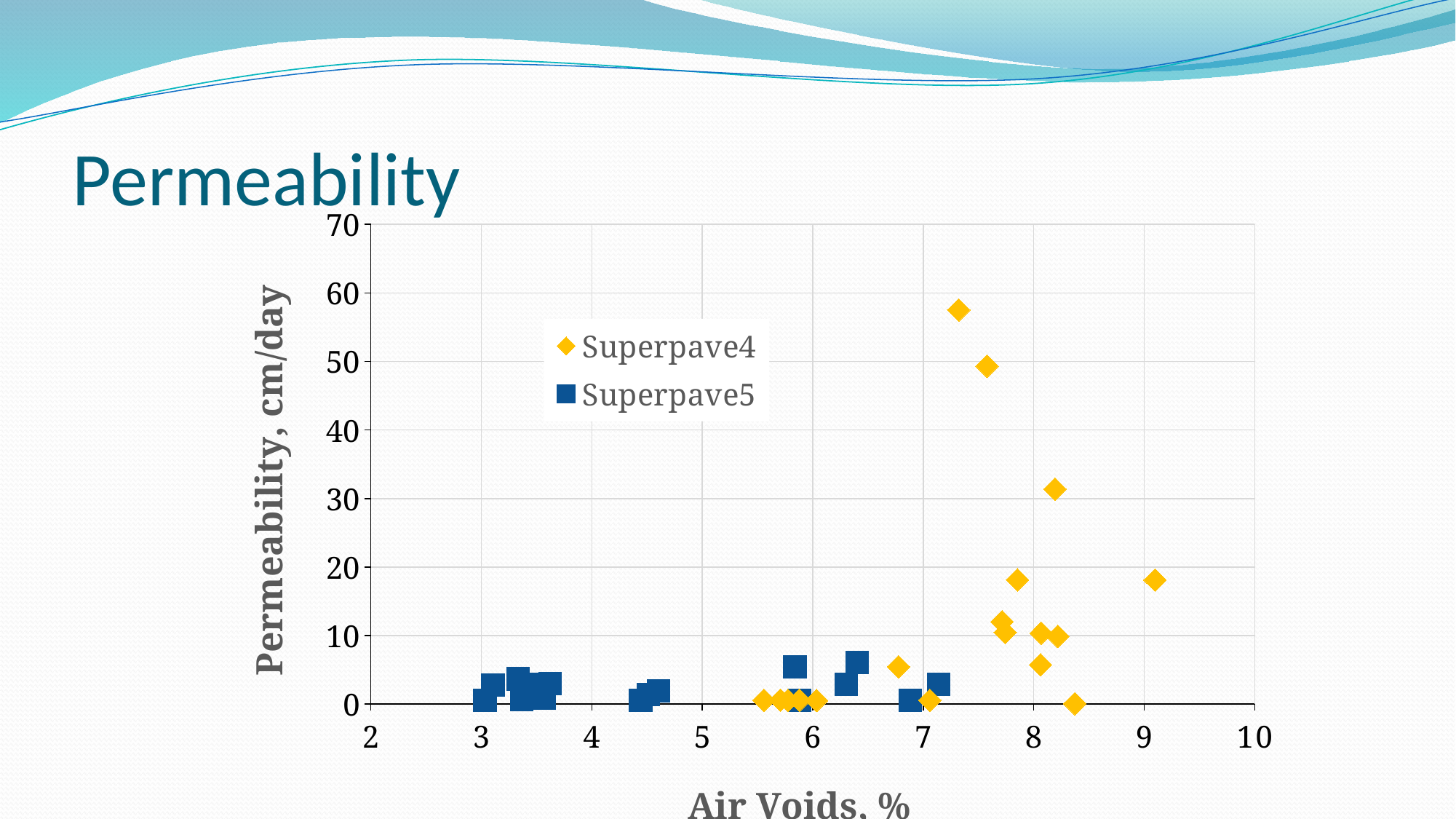
What is the maximum value shown on the permeability (y) axis? 70 For the Superpave4 series, does permeability generally rise or fall as air voids increase from 6% to 8%? rise Which series has points at the lowest air void percentages (around 3%)? Superpave5 Is the highest Superpave5 permeability value greater or less than 10 cm/day? less Is the highest Superpave4 permeability value greater or less than 50 cm/day? greater Is the Superpave4 point with the highest air voids (around 9%) greater or less than 20 cm/day in permeability? less What are the two series named in the legend? Superpave4 and Superpave5 What is the title of the slide's chart? Permeability How many series does the legend list? 2 What kind of chart is shown on the slide? Scatter chart Which series reaches higher permeability values, Superpave4 or Superpave5? Superpave4 Which series contains the point with the highest permeability? Superpave4